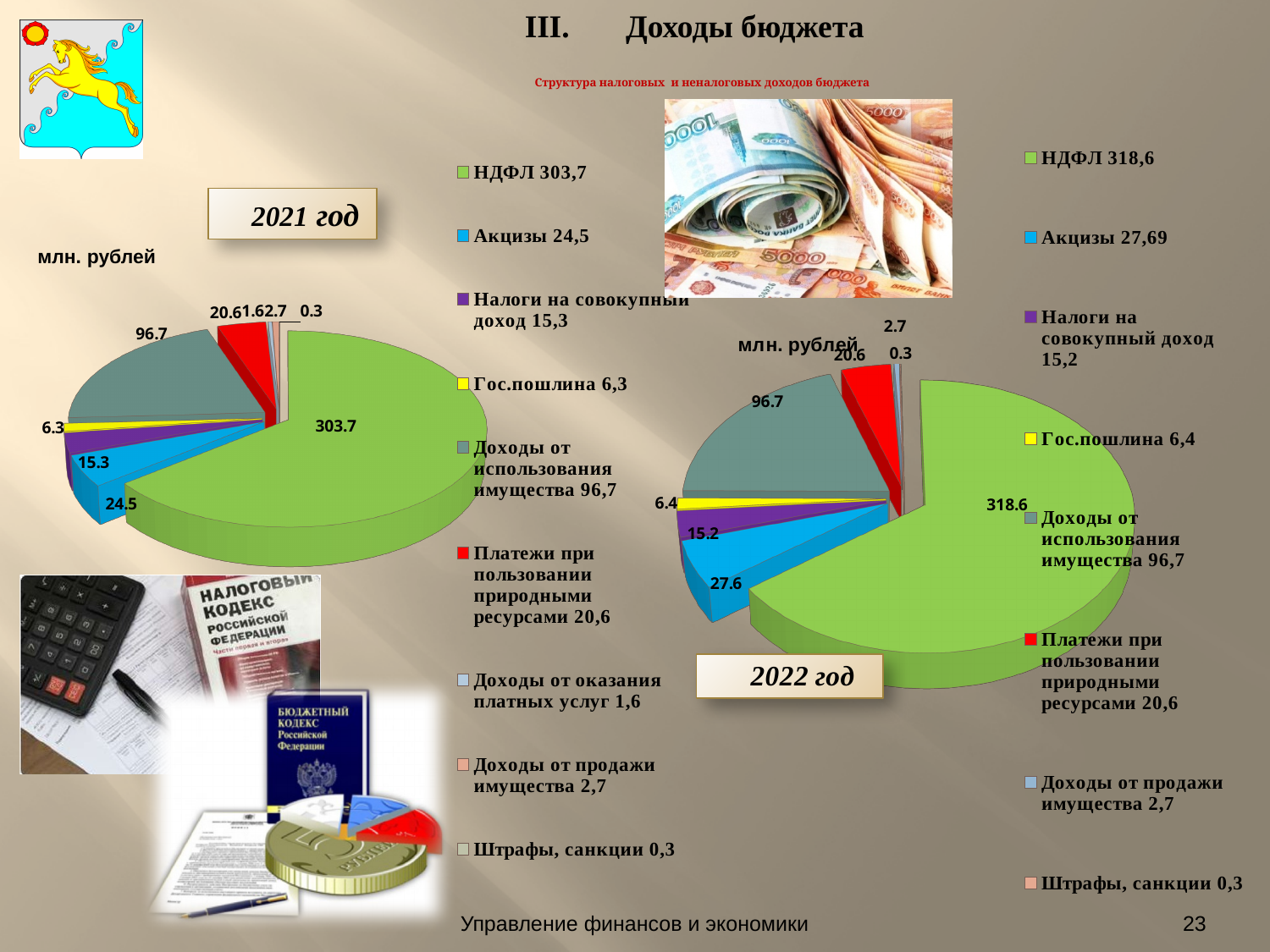
In the 2022 год chart, what is the value for Налоги на совокупный доход? 15,2 In the 2022 год chart, what is the value for Гос.пошлина? 6,4 In what units are the values of the two pie charts given? млн. рублей By how much is НДФЛ in the 2022 год chart larger than НДФЛ in the 2021 год chart? 14,9 In the 2021 год chart, which category has the smallest value? Штрафы, санкции How many categories does the 2021 год chart show? 9 In the 2021 год chart, what is the value for НДФЛ? 303,7 How many categories does the 2022 год chart show? 8 In the 2021 год chart, what is the difference between Доходы от использования имущества and Акцизы? 72,2 In the 2021 год chart, which is larger: Акцизы or Доходы от использования имущества? Доходы от использования имущества In the 2021 год chart, which category has the largest value? НДФЛ What kind of chart is used for the 2021 год chart? pie chart